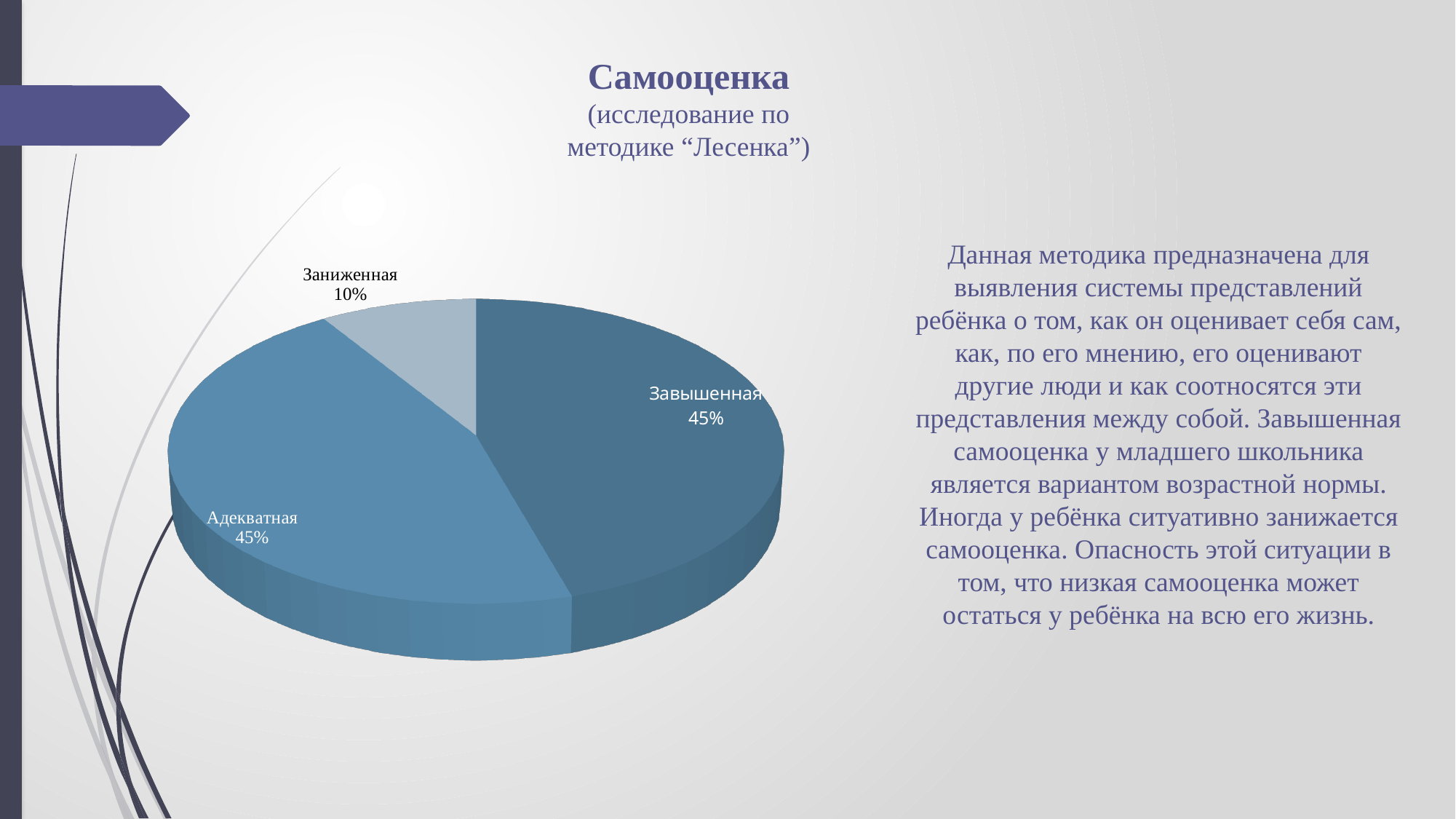
Which category has the smallest slice of the pie? Заниженная What share of the pie does the "Заниженная" slice represent? 10% What share of the pie does the "Завышенная" slice represent? 45% Which slice is larger, "Завышенная" or "Заниженная"? Завышенная What is the combined share of the "Завышенная" and "Адекватная" slices? 90% Which slice is larger, "Адекватная" or "Заниженная"? Адекватная What kind of chart is shown on the slide? Pie chart By how many percentage points does the "Завышенная" slice exceed the "Заниженная" slice? 35 percentage points By how many percentage points does the "Адекватная" slice exceed the "Заниженная" slice? 35 percentage points What share of the pie does the "Адекватная" slice represent? 45% What is the title of the chart on the slide? Самооценка (исследование по методике "Лесенка") How many categories (slices) are shown in the pie chart? 3